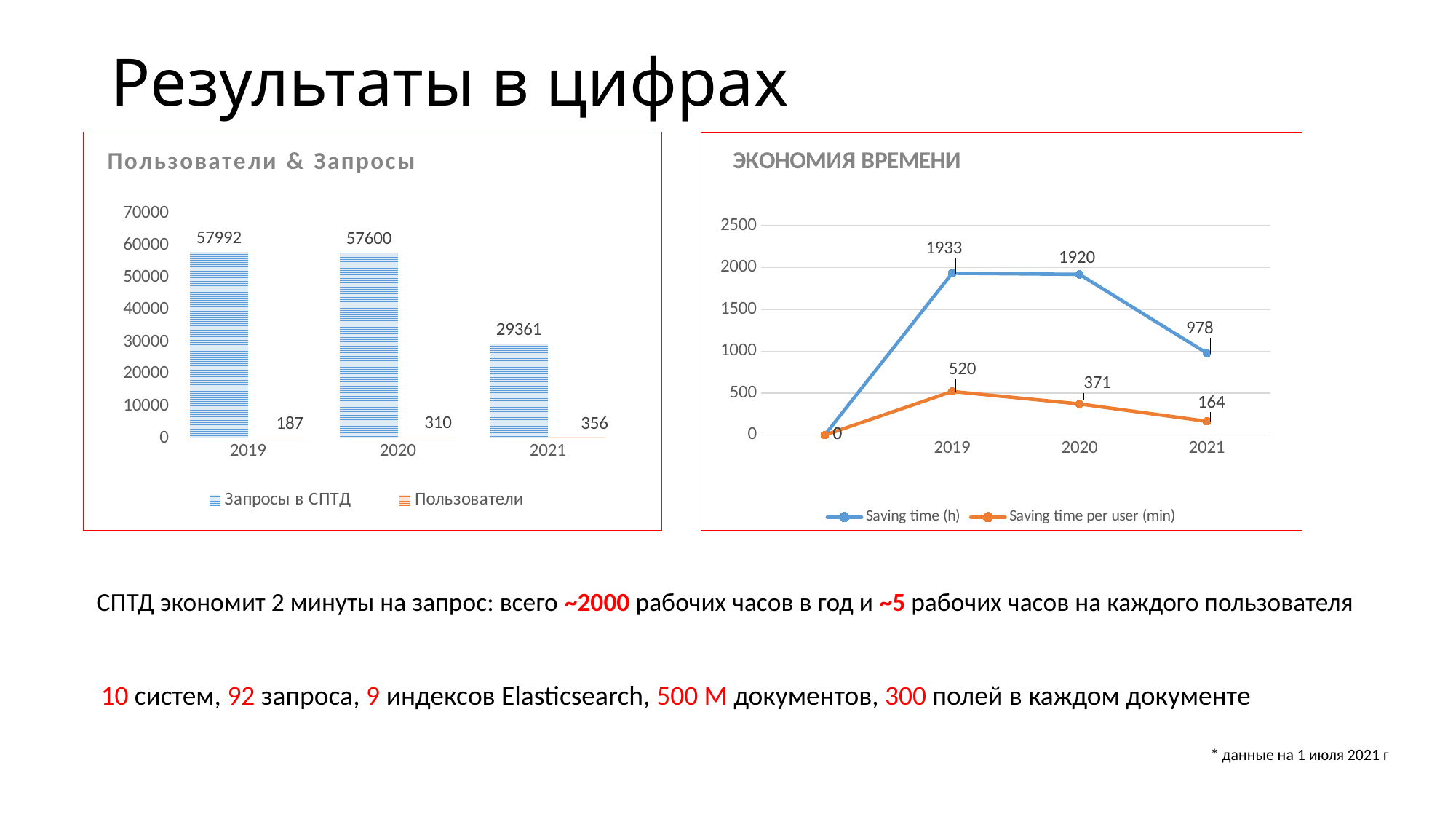
In the 'ЭКОНОМИЯ ВРЕМЕНИ' chart, which year has the highest value for Saving time (h)? 2019 In the 'ЭКОНОМИЯ ВРЕМЕНИ' chart, what is the value of Saving time (h) for 2020? 1920 In the 'Пользователи & Запросы' chart, what is the value of Пользователи for 2021? 356 In the 'Пользователи & Запросы' chart, do the Пользователи values rise or fall from 2019 to 2021? Rise In the 'Пользователи & Запросы' chart, how many series does the legend list? 2 What kind of chart is the 'Пользователи & Запросы' chart? Bar chart What kind of chart is the 'ЭКОНОМИЯ ВРЕМЕНИ' chart? Line chart In the 'Пользователи & Запросы' chart, which year has the lowest value for Запросы в СПТД? 2021 In the 'Пользователи & Запросы' chart, what is the value of Запросы в СПТД for 2019? 57992 In the 'Пользователи & Запросы' chart, what is the difference between the Запросы в СПТД values for 2019 and 2020? 392 In the 'ЭКОНОМИЯ ВРЕМЕНИ' chart, what is the difference between Saving time per user (min) for 2020 and 2021? 207 In the 'ЭКОНОМИЯ ВРЕМЕНИ' chart, what is the value of Saving time per user (min) for 2019? 520